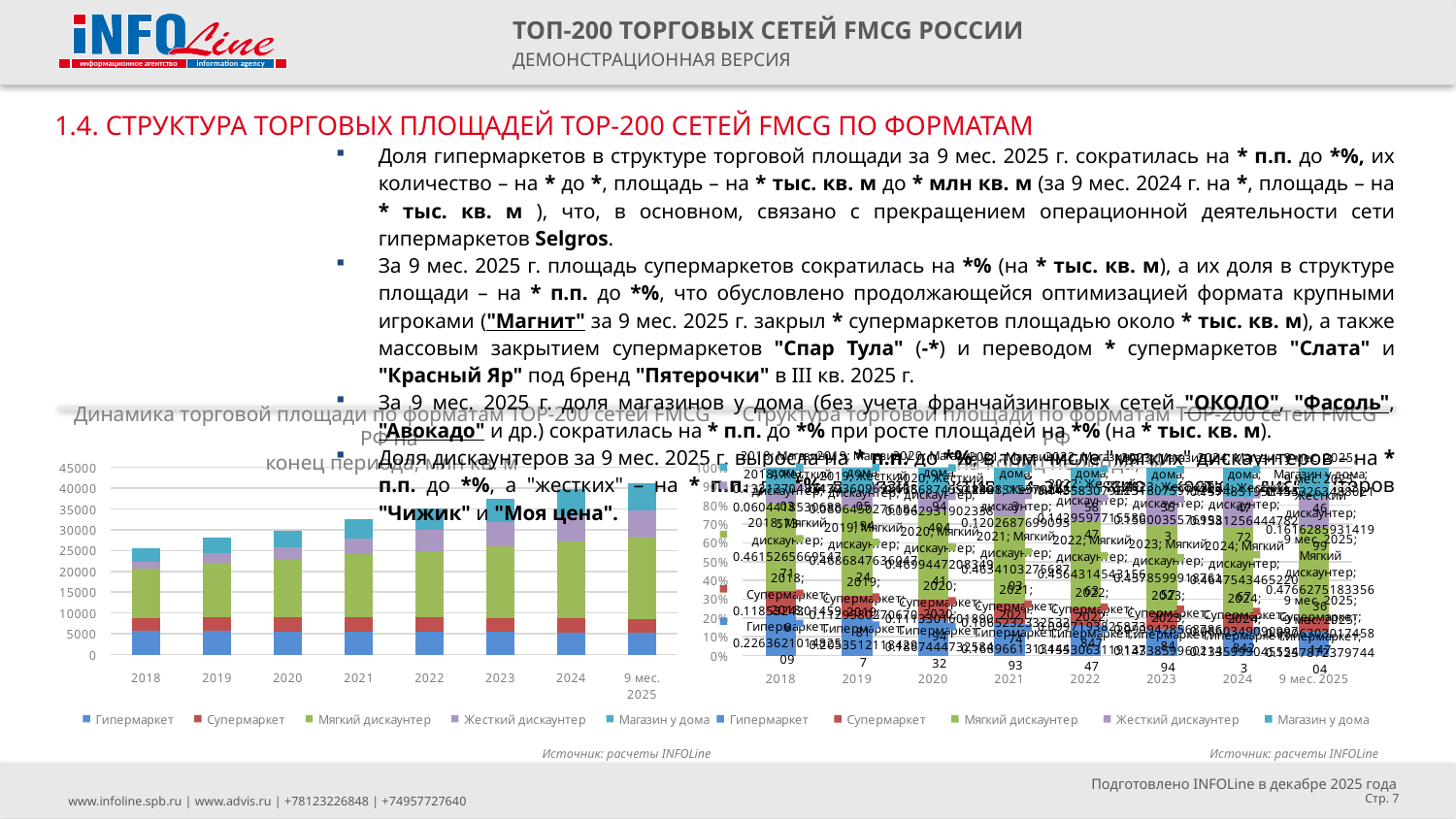
In the left chart, which period has the tallest stacked bar (largest total trading area)? 9 мес. 2025 In the left chart, is the total stacked bar for 2018 greater or less than 30000? less How many series does the legend of the right chart list? 5 What kind of chart is the left chart, 'Динамика торговой площади по форматам TOP-200 сетей FMCG РФ на конец периода, млн кв. м'? Stacked bar chart In the left chart, which series is shown in green? Мягкий дискаунтер In the left chart, is the total stacked bar for 2024 greater or less than 35000? greater How many periods (categories) are shown on the x axis of the left chart? 8 How many series does the legend of the left chart list? 5 In the left chart, which is larger: the total bar for 2020 or the total bar for 2023? 2023 In the left chart, does the total trading area rise or fall from 2018 to 9 мес. 2025? Rises In the left chart, which period has the shortest stacked bar (smallest total trading area)? 2018 What kind of chart is the right chart, 'Структура торговой площади по форматам TOP-200 сетей FMCG РФ'? 100% stacked bar chart